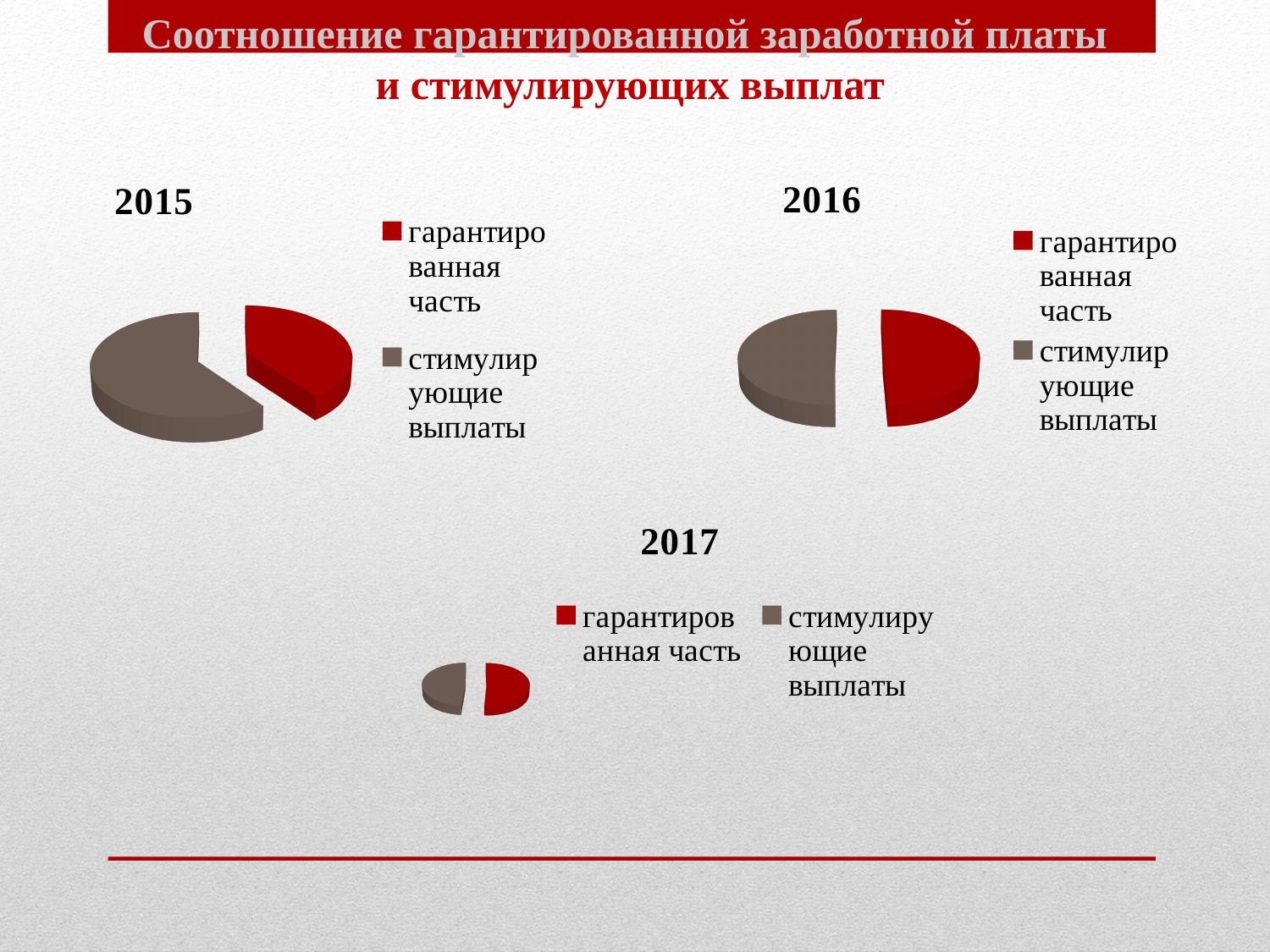
In the 2015 pie chart, which slice is larger: гарантированная часть or стимулирующие выплаты? стимулирующие выплаты What kind of chart is the 2017 chart? pie chart What is the title of the pie chart in the top right of the slide? 2016 What colour represents гарантированная часть in the 2017 pie chart? red In the 2015 pie chart, which category has the smallest slice? гарантированная часть In the 2015 pie chart, which category has the largest slice? стимулирующие выплаты How many slices does the 2015 pie chart have? 2 How many entries does the legend of the 2016 chart list? 2 How many slices does the 2017 pie chart have? 2 How many pie charts are shown on the slide? 3 What kind of chart is the 2015 chart? pie chart